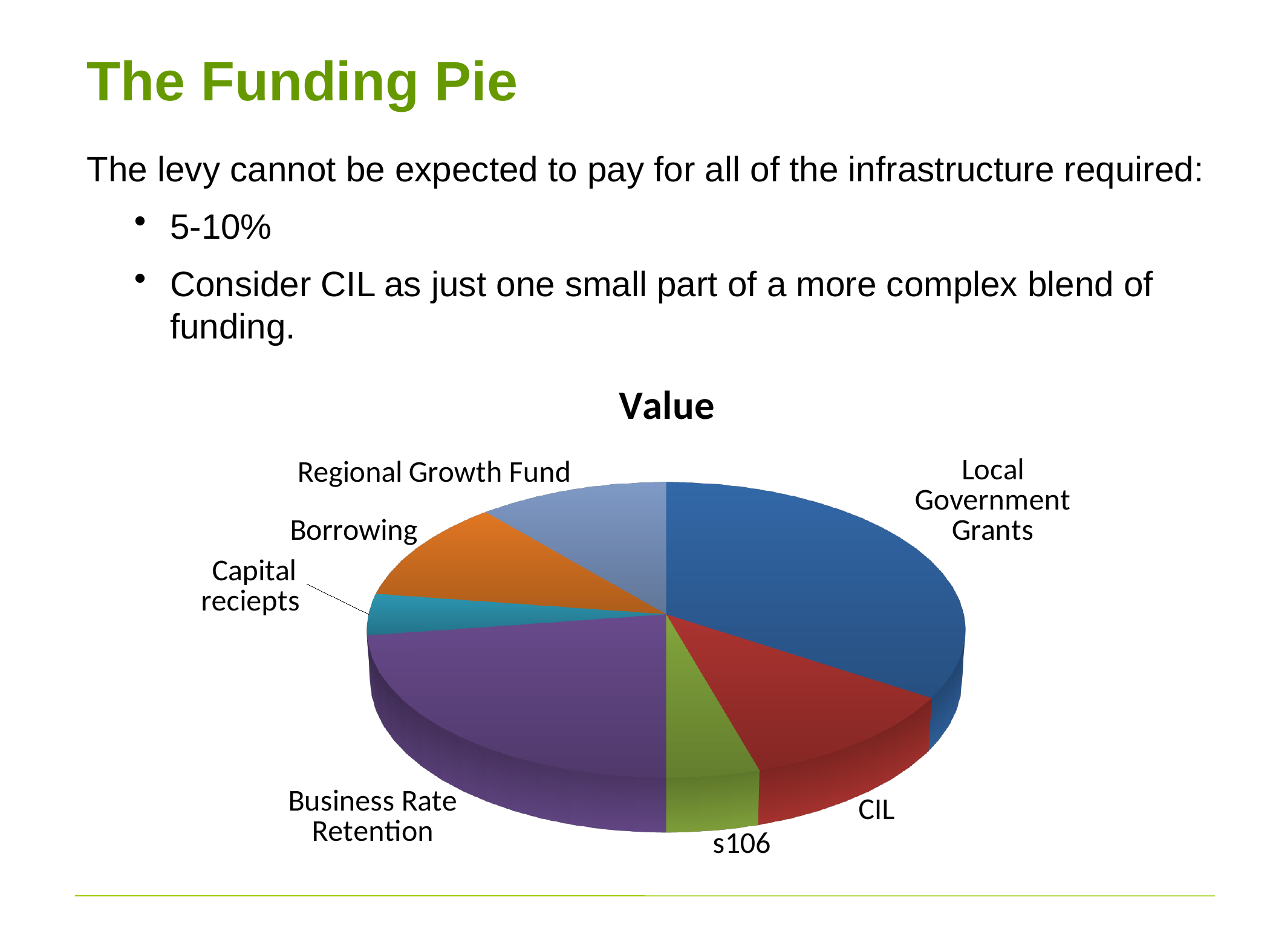
What kind of chart is shown on the slide? Pie chart Which slice is larger, CIL or s106? CIL Which slice is larger, Local Government Grants or s106? Local Government Grants What colour is the CIL slice in the pie chart? Red Which slice is larger, Borrowing or Capital reciepts? Borrowing How many slices does the pie chart have? 7 Which category has the largest slice of the pie chart? Local Government Grants What is the title of the pie chart? Value